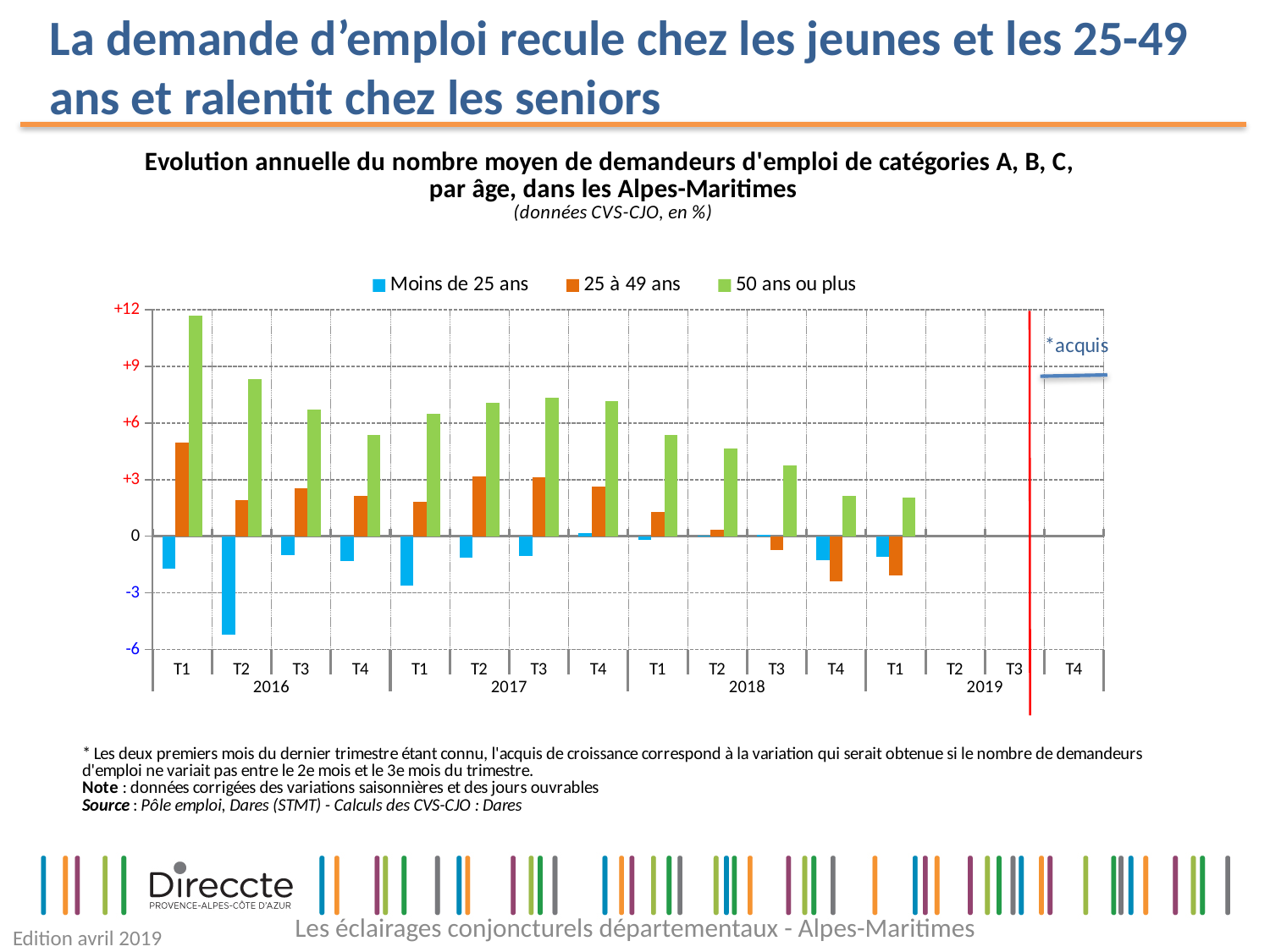
Do the values for '50 ans ou plus' rise or fall from T1 2018 to T1 2019? fall Is the value for '25 à 49 ans' in T1 2016 greater or less than +3? greater Which is larger in T4 2018: the value for '25 à 49 ans' or for '50 ans ou plus'? 50 ans ou plus In which quarter is the value for '50 ans ou plus' the highest? T1 2016 What are the three series named in the legend? Moins de 25 ans, 25 à 49 ans, 50 ans ou plus In which quarter is the value for 'Moins de 25 ans' the lowest? T2 2016 Is the value for 'Moins de 25 ans' in T2 2016 greater or less than -3? less How many years are labelled on the x axis? 4 How many series does the legend list? 3 Is the value for '50 ans ou plus' in T1 2016 greater or less than +9? greater Which is larger: the value for '50 ans ou plus' in T1 2016 or in T2 2016? T1 2016 What kind of chart is shown on the slide? bar chart